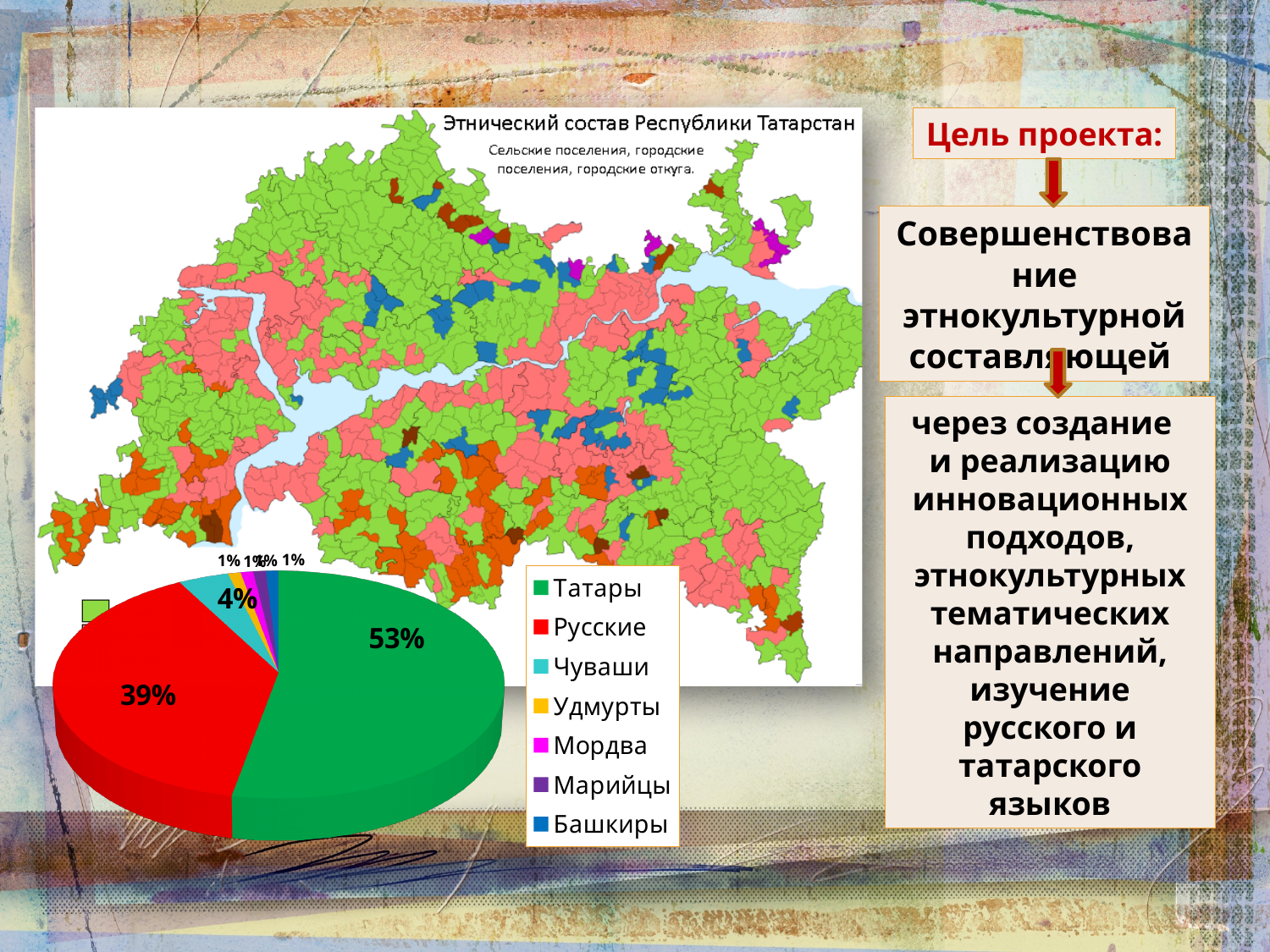
In the pie chart, what share is shown for Русские? 39% What colour represents Башкиры in the pie chart's legend? Blue What kind of chart is shown at the bottom left of the slide? Pie chart How many groups are listed in the pie chart's legend? 7 What colour represents Татары in the pie chart? Green In the pie chart, what share is shown for Удмурты? 1% In the pie chart, what share is shown for Татары? 53% In the pie chart, how many percentage points larger is the Татары share than the Русские share? 14 percentage points In the pie chart, which slice is larger: Русские or Чуваши? Русские In the pie chart, how many percentage points larger is the Русские share than the Чуваши share? 35 percentage points Which group has the largest slice in the pie chart? Татары In the pie chart, what share is shown for Чуваши? 4%